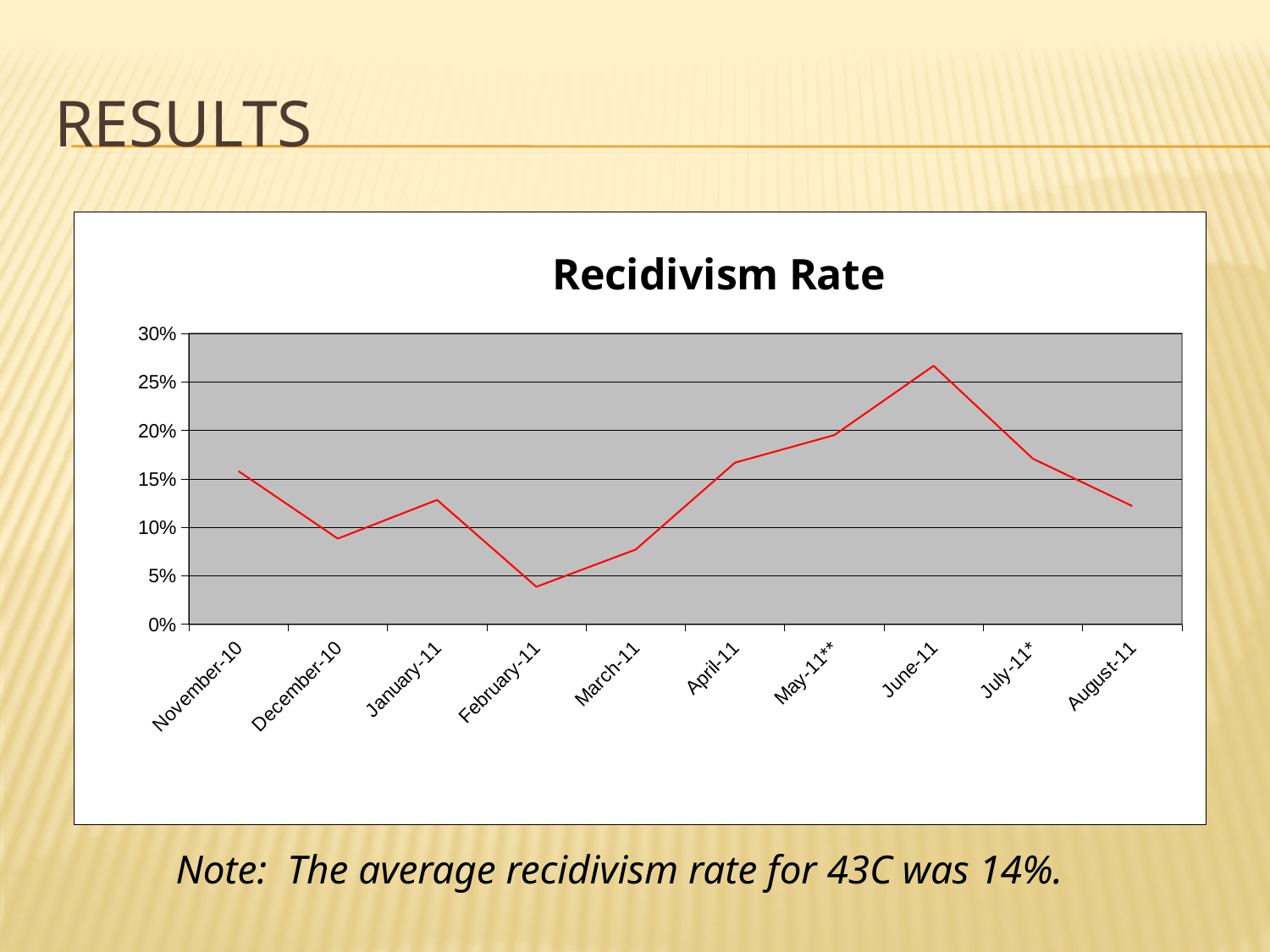
Which month has the lowest recidivism rate? February-11 Is the recidivism rate for June-11 greater or less than 25%? greater Is the recidivism rate for November-10 greater or less than 15%? greater What kind of chart is shown on the slide? line chart Is the recidivism rate for February-11 greater or less than 5%? less How many months are plotted on the x axis of the chart? 10 Which month has a higher recidivism rate, May-11** or August-11? May-11** Does the recidivism rate rise or fall from February-11 to June-11? rise What is the title of the chart? Recidivism Rate Does the recidivism rate rise or fall from June-11 to August-11? fall Which month has the highest recidivism rate? June-11